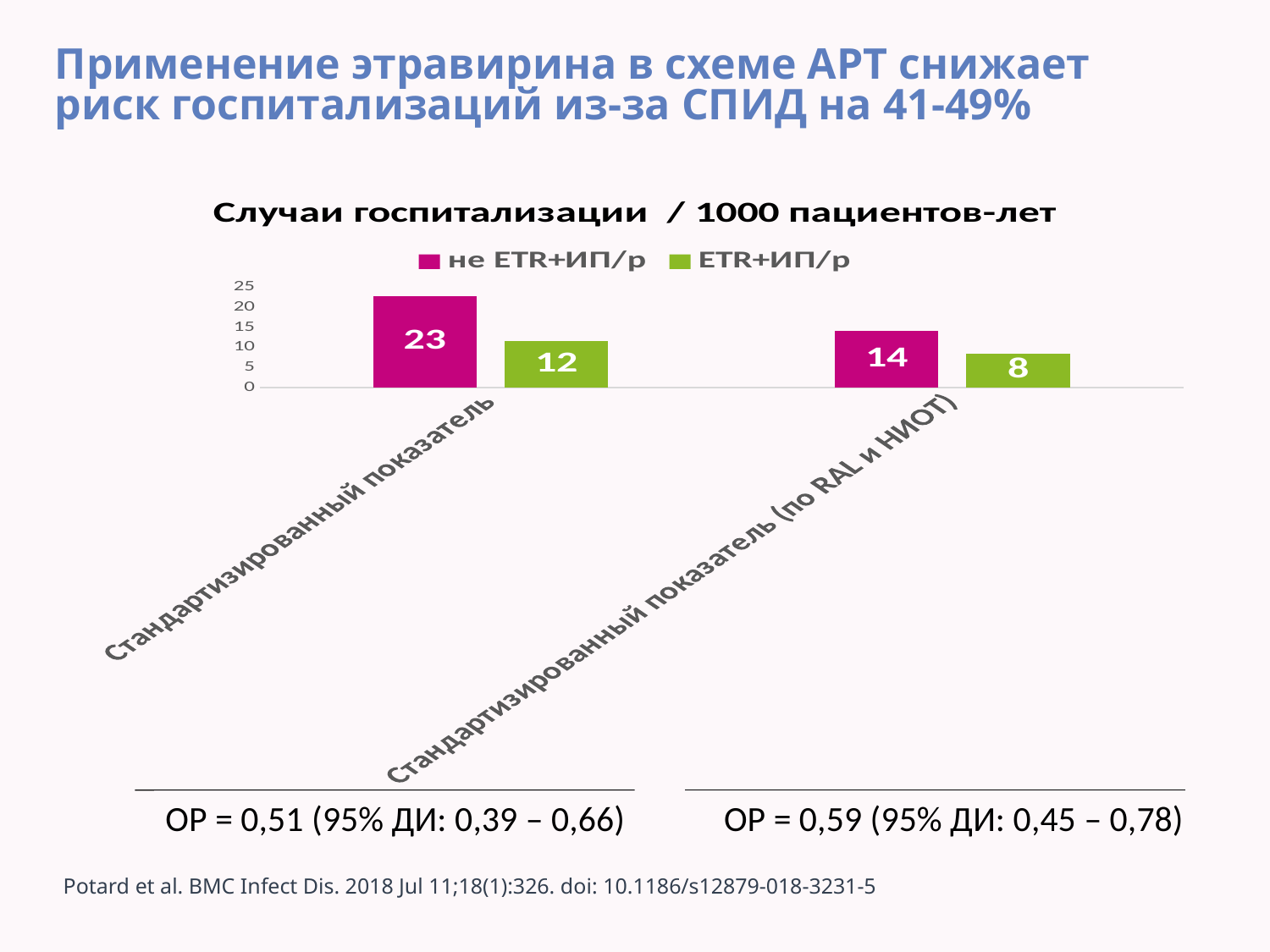
What is the value for "ETR+ИП/р" in the "Стандартизированный показатель (по RAL и НИОТ)" category? 8 In the "Стандартизированный показатель (по RAL и НИОТ)" category, which series has the larger value, "не ETR+ИП/р" or "ETR+ИП/р"? не ETR+ИП/р What is the value for "ETR+ИП/р" in the "Стандартизированный показатель" category? 12 Which bar has the highest value on the chart? не ETR+ИП/р, Стандартизированный показатель What is the value for "не ETR+ИП/р" in the "Стандартизированный показатель" category? 23 What is the difference between the "не ETR+ИП/р" and "ETR+ИП/р" values in the "Стандартизированный показатель" category? 11 What is the difference between the "не ETR+ИП/р" and "ETR+ИП/р" values in the "Стандартизированный показатель (по RAL и НИОТ)" category? 6 What is the value for "не ETR+ИП/р" in the "Стандартизированный показатель (по RAL и НИОТ)" category? 14 What is the title of the chart? Случаи госпитализации / 1000 пациентов-лет How many series does the legend list? 2 What kind of chart is shown on the slide? Bar chart Which bar has the lowest value on the chart? ETR+ИП/р, Стандартизированный показатель (по RAL и НИОТ)